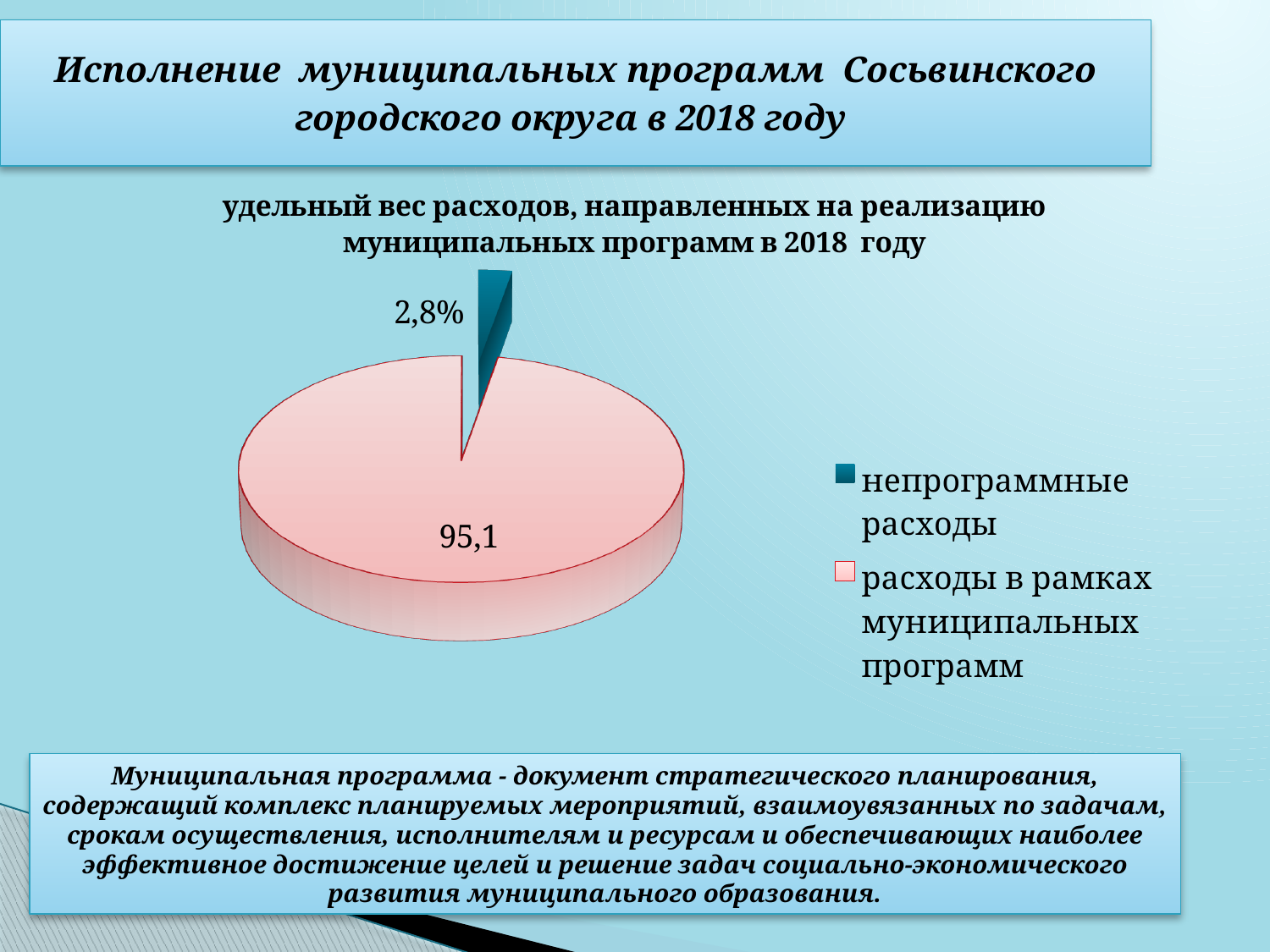
How many slices does the pie chart have? 2 Which category has the largest slice of the pie? расходы в рамках муниципальных программ How many entries does the legend list? 2 What share of the pie does the slice "непрограммные расходы" represent? 2,8% What is the value shown for the slice "непрограммные расходы"? 2,8% What is the value shown for the slice "расходы в рамках муниципальных программ"? 95,1 What colour is the slice for "непрограммные расходы"? dark teal (blue) What is the difference between the values for "расходы в рамках муниципальных программ" (95,1) and "непрограммные расходы" (2,8)? 92,3 What is the title of the pie chart? удельный вес расходов, направленных на реализацию муниципальных программ в 2018 году Which is larger: "непрограммные расходы" or "расходы в рамках муниципальных программ"? расходы в рамках муниципальных программ Which category has the smallest slice of the pie? непрограммные расходы What kind of chart is shown on the slide? pie chart